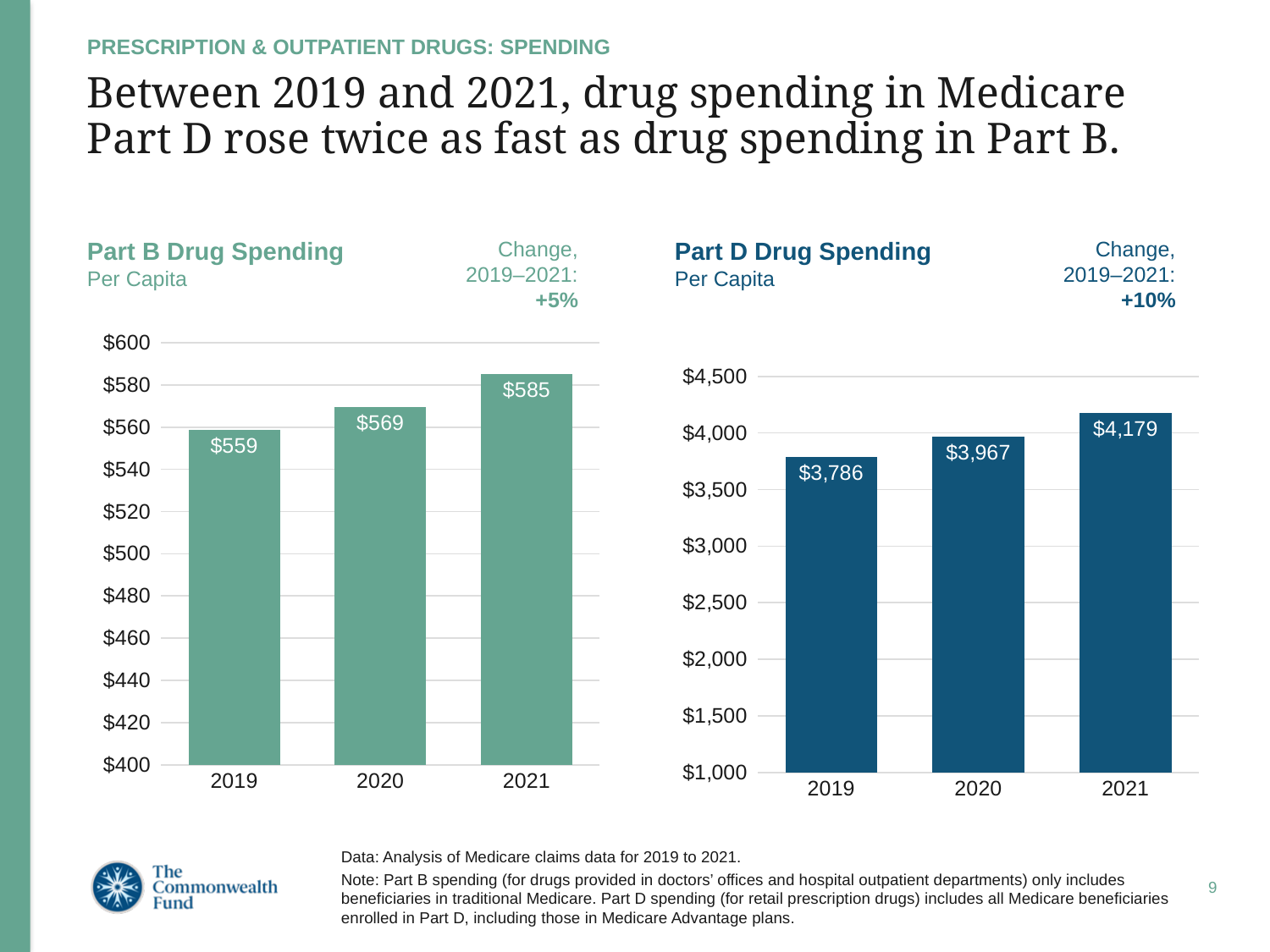
What kind of chart is the Part B Drug Spending chart? bar chart In the Part D Drug Spending chart, which year has the lowest value? 2019 In the Part B Drug Spending chart, what is the difference between the 2021 and 2019 values? $26 In the Part D Drug Spending chart, what is the per capita value for 2019? $3,786 In the Part D Drug Spending chart, which is larger, the value for 2020 or the value for 2021? 2021 In the Part B Drug Spending chart, what is the per capita value for 2020? $569 In the Part B Drug Spending chart, is the value for 2019 greater or less than $560? less In the Part B Drug Spending chart, which year has the highest value? 2021 How many years are shown in the Part D Drug Spending chart? 3 In the Part D Drug Spending chart, what is the per capita value for 2021? $4,179 In the Part D Drug Spending chart, do the values rise or fall from 2019 to 2021? rise In the Part D Drug Spending chart, what is the difference between the 2020 and 2019 values? $181